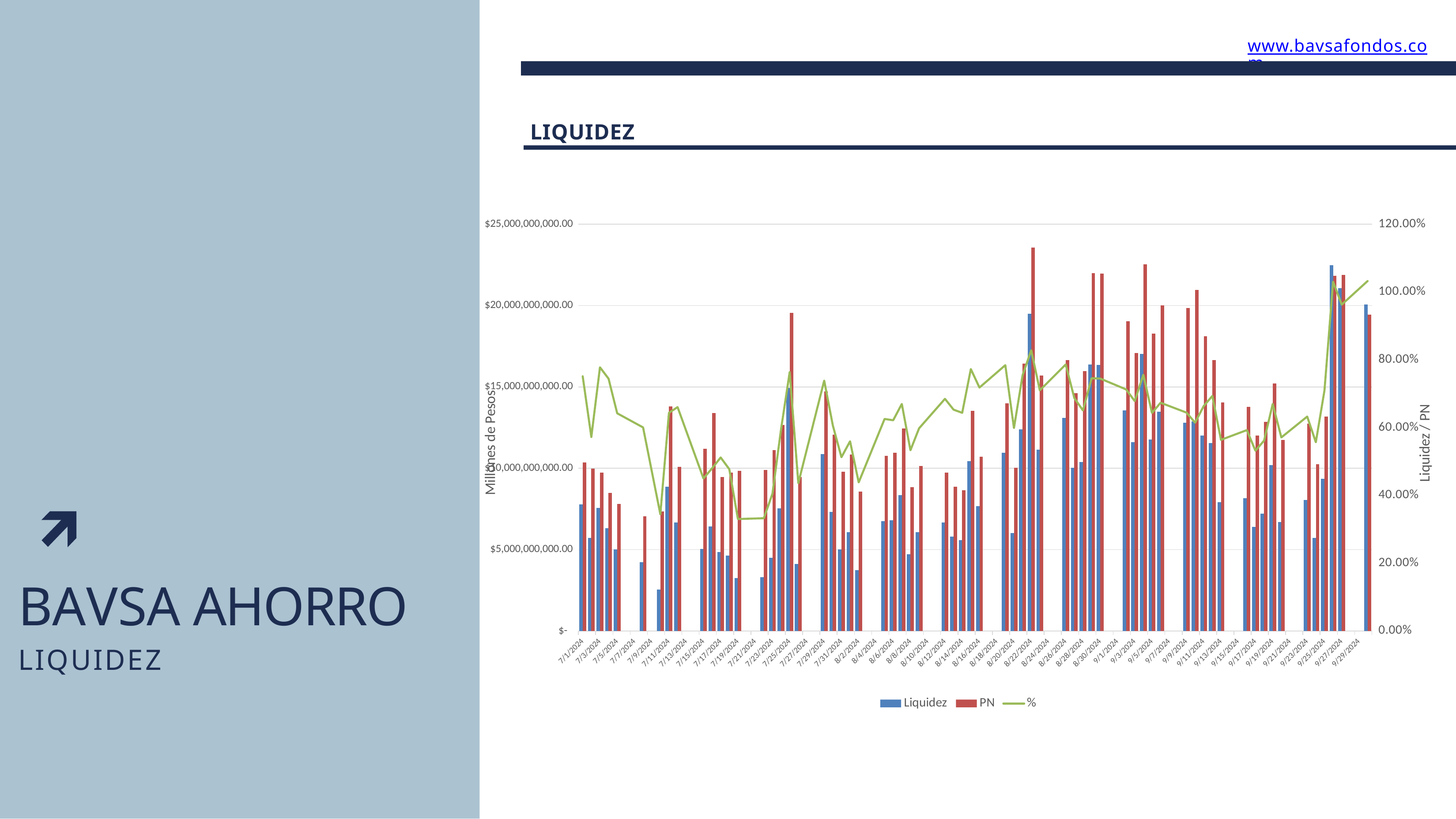
What are the series names listed in the legend? Liquidez, PN, % Is the Liquidez value for 7/1/2024 greater or less than $10,000,000,000.00? less What is the highest tick value shown on the right vertical axis? 120.00% What kind of chart is shown on the slide? A combined bar and line chart On 7/1/2024, which is larger, the Liquidez bar or the PN bar? PN Is the PN value for 7/1/2024 greater or less than $5,000,000,000.00? greater What is the title of the chart? LIQUIDEZ How many series does the legend list? 3 What is the highest tick value shown on the left vertical axis? $25,000,000,000.00